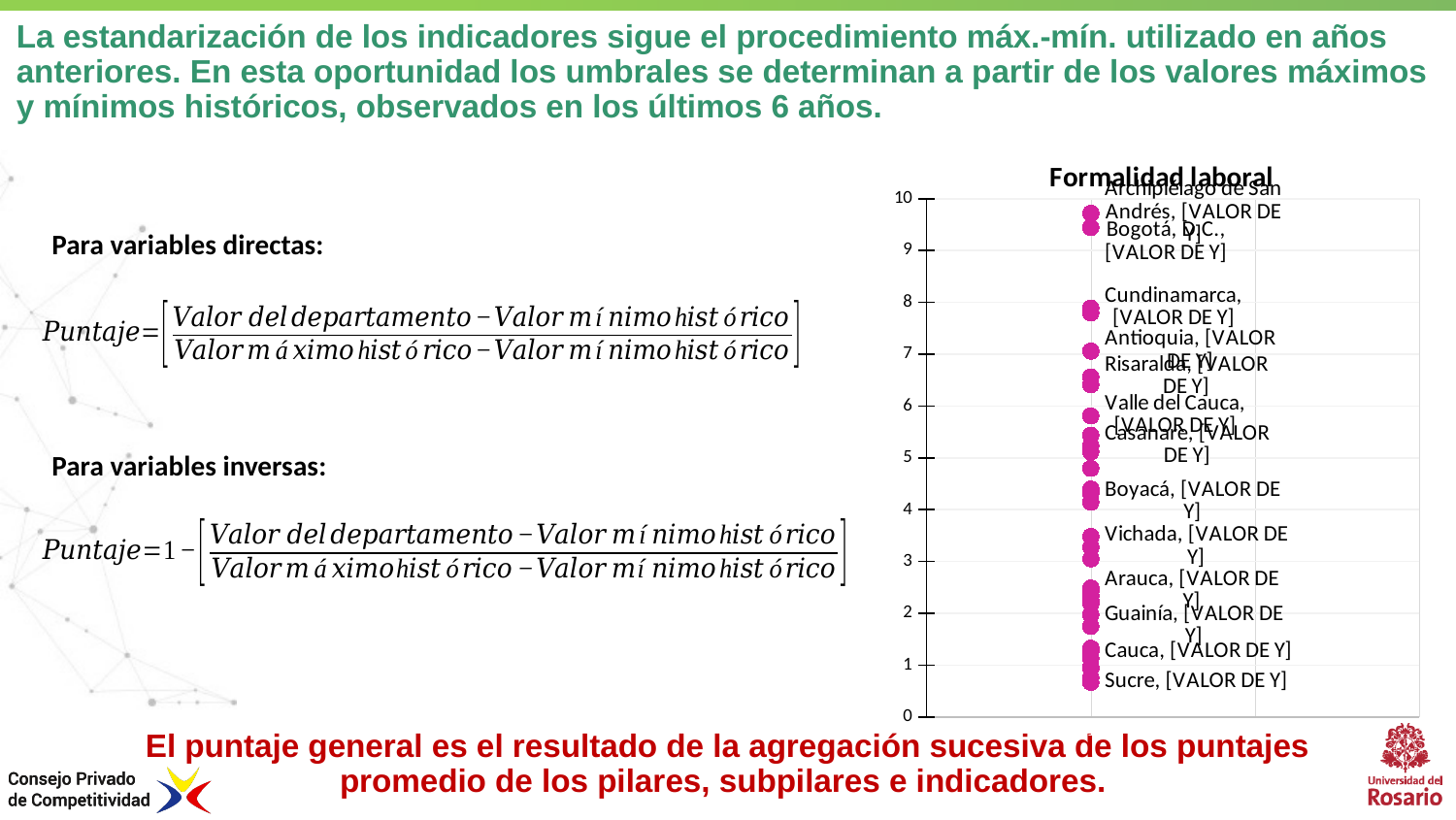
What is the maximum value shown on the y axis of the 'Formalidad laboral' chart? 10 In the 'Formalidad laboral' chart, which has a higher value, Cundinamarca or Boyacá? Cundinamarca In the 'Formalidad laboral' chart, is the value for Arauca greater or less than 3? less In the 'Formalidad laboral' chart, which labeled department has the highest value? Archipiélago de San Andrés In the 'Formalidad laboral' chart, is the value for Archipiélago de San Andrés greater or less than 9? greater In the 'Formalidad laboral' chart, which labeled department has the lowest value? Sucre In the 'Formalidad laboral' chart, is the value for Valle del Cauca greater or less than 5? greater What is the title of the chart on the slide? Formalidad laboral What kind of chart is the 'Formalidad laboral' chart? scatter chart